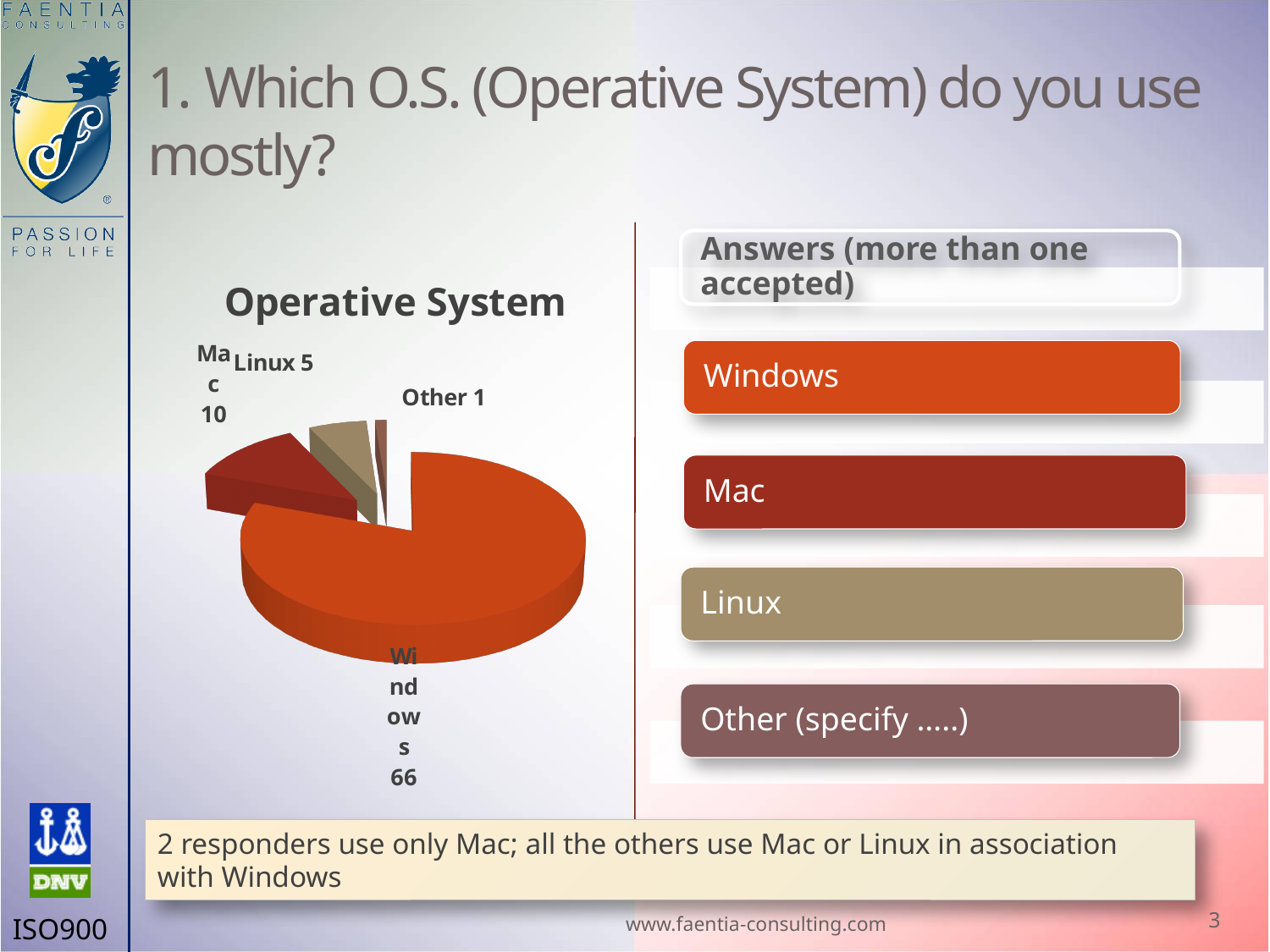
How many categories are shown in the pie chart? 4 What is the value for Linux in the pie chart? 5 What is the value for Windows in the pie chart? 66 What is the value for Other in the pie chart? 1 Which is larger, the value for Mac or the value for Linux? Mac What is the difference between the Windows and Mac values? 56 Which category has the smallest slice in the pie chart? Other What type of chart is shown on the slide? Pie chart Which category has the largest slice in the pie chart? Windows What is the title of the chart? Operative System What is the value for Mac in the pie chart? 10 What is the total of all values in the pie chart? 82